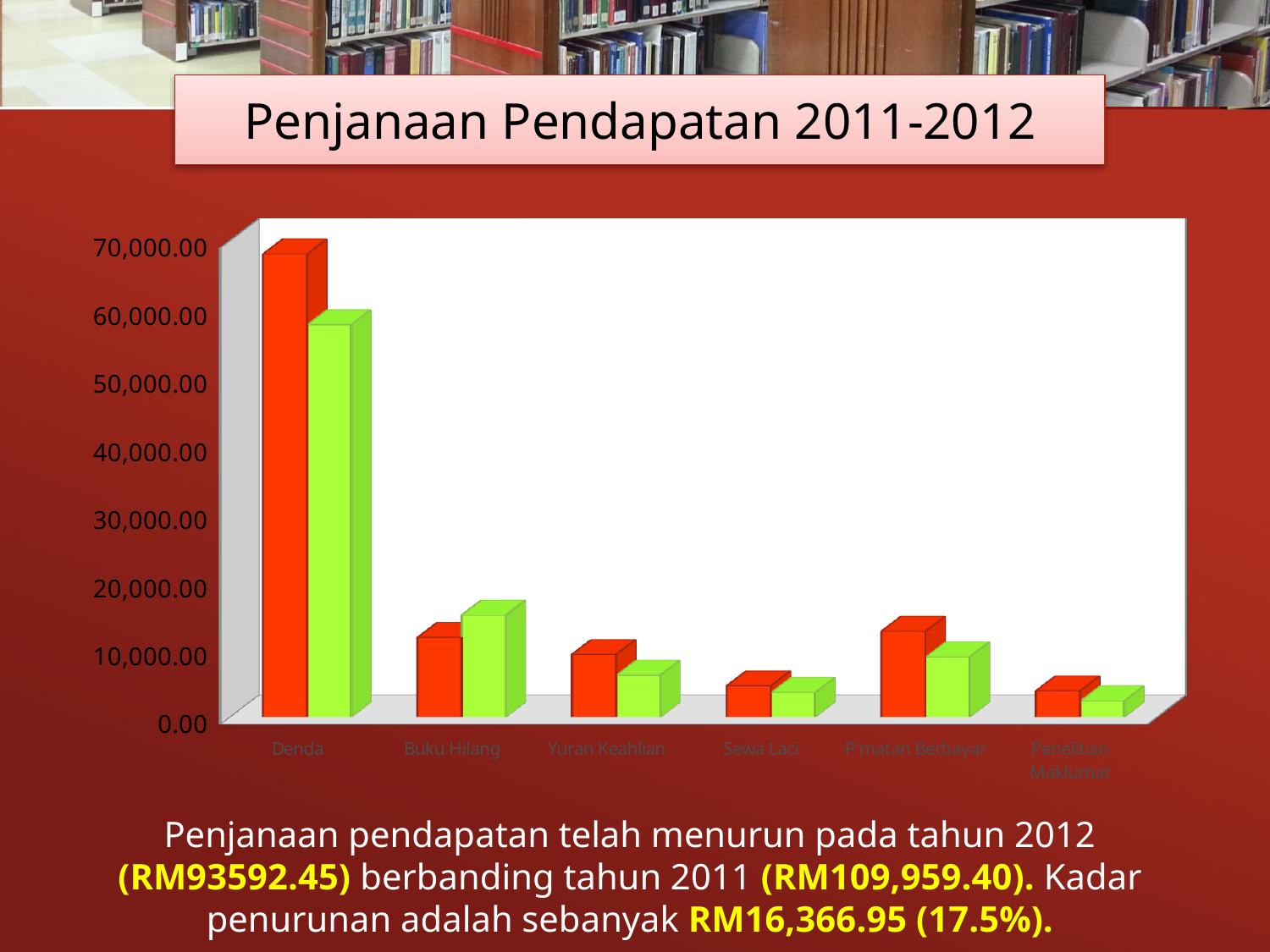
Is the red bar for Denda greater or less than 60,000.00? greater Is the red bar for Buku Hilang greater or less than 20,000.00? less Which category has the highest green bar? Denda Which category has the highest red bar? Denda What is the title shown above the chart? Penjanaan Pendapatan 2011-2012 For Yuran Keahlian, which bar is larger, the red bar or the green bar? red bar Is the green bar for Denda greater or less than 50,000.00? greater How many categories are shown on the x axis of the chart? 6 For Buku Hilang, which bar is larger, the red bar or the green bar? green bar What kind of chart is shown on the slide? bar chart